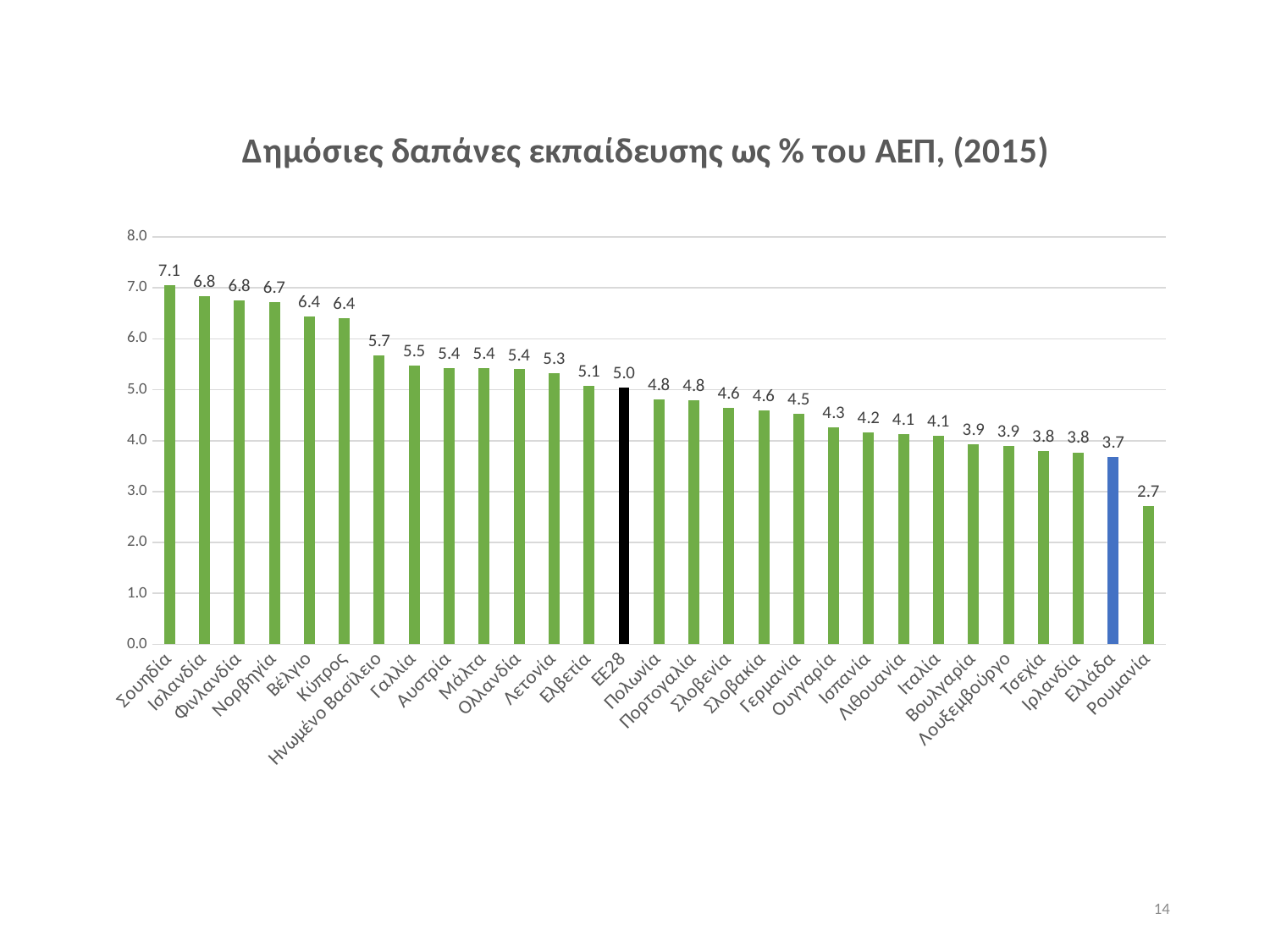
What is the difference between the values for ΕΕ28 and Ελλάδα? 1.3 Which is larger, the value for Πολωνία or the value for Γερμανία? Πολωνία Do the values rise or fall from left to right along the x axis? Fall Which country has the lowest value? Ρουμανία What is the value for ΕΕ28? 5.0 What is the value for Ελλάδα? 3.7 What is the value for Ηνωμένο Βασίλειο? 5.7 What is the difference between the values for Σουηδία and Ελλάδα? 3.4 Which category is drawn with a blue bar? Ελλάδα Which country has the highest value? Σουηδία How many bars are shown in the chart? 29 What kind of chart is shown on the slide? Bar chart